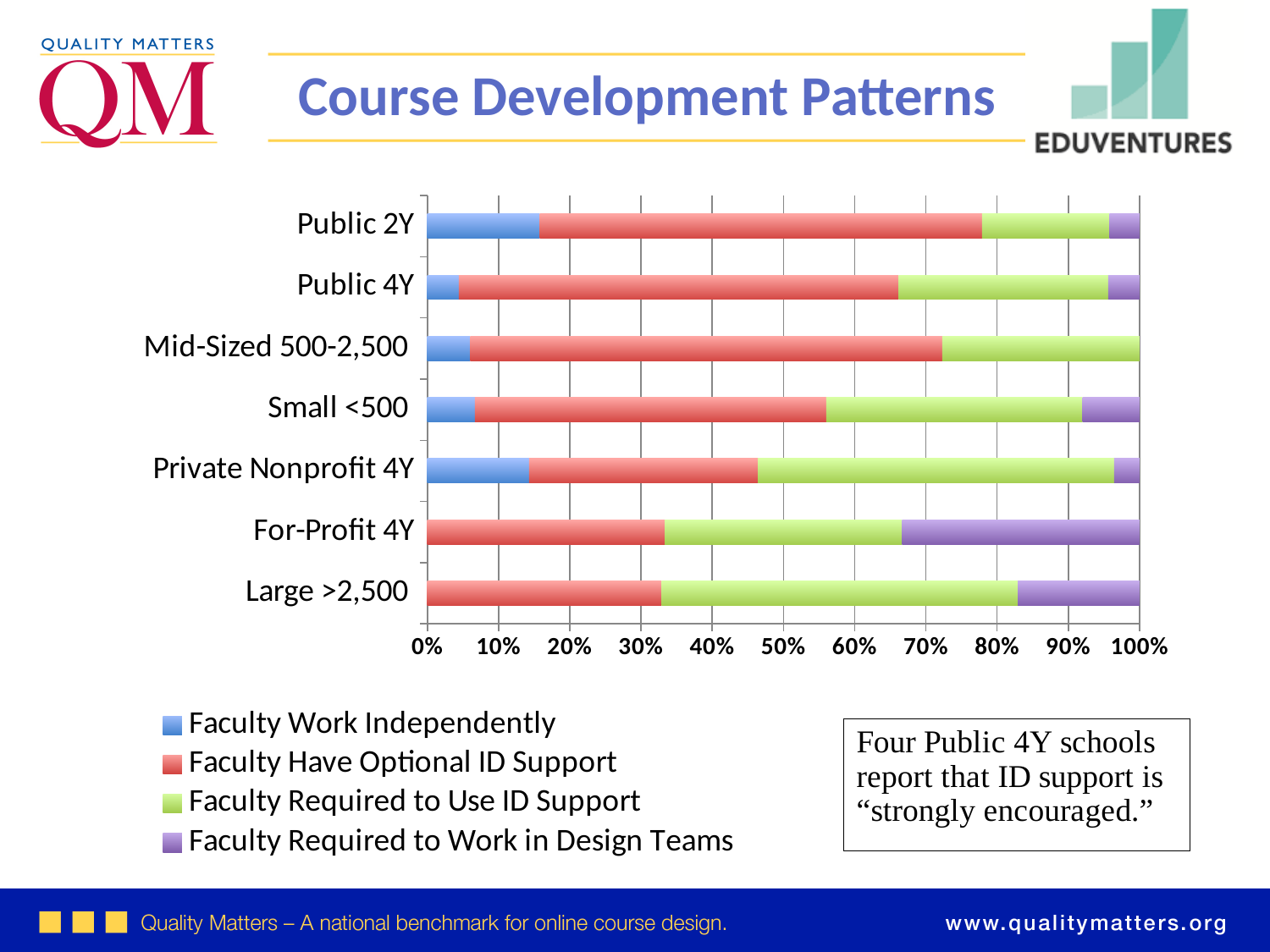
Is the 'Faculty Work Independently' share for Public 2Y greater or less than 10%? greater How many series does the legend list? 4 Which series is shown in purple in the legend? Faculty Required to Work in Design Teams Which has the larger 'Faculty Required to Work in Design Teams' share, For-Profit 4Y or Public 2Y? For-Profit 4Y Is the 'Faculty Required to Work in Design Teams' share for For-Profit 4Y greater or less than 20%? greater Which has the larger 'Faculty Work Independently' share, Public 2Y or Public 4Y? Public 2Y Which category has the largest 'Faculty Required to Work in Design Teams' share? For-Profit 4Y How many institution categories are plotted on the chart? 7 Is the 'Faculty Have Optional ID Support' share for Public 2Y greater or less than 50%? greater What kind of chart is shown on the slide? Stacked bar chart What is the title of the chart? Course Development Patterns